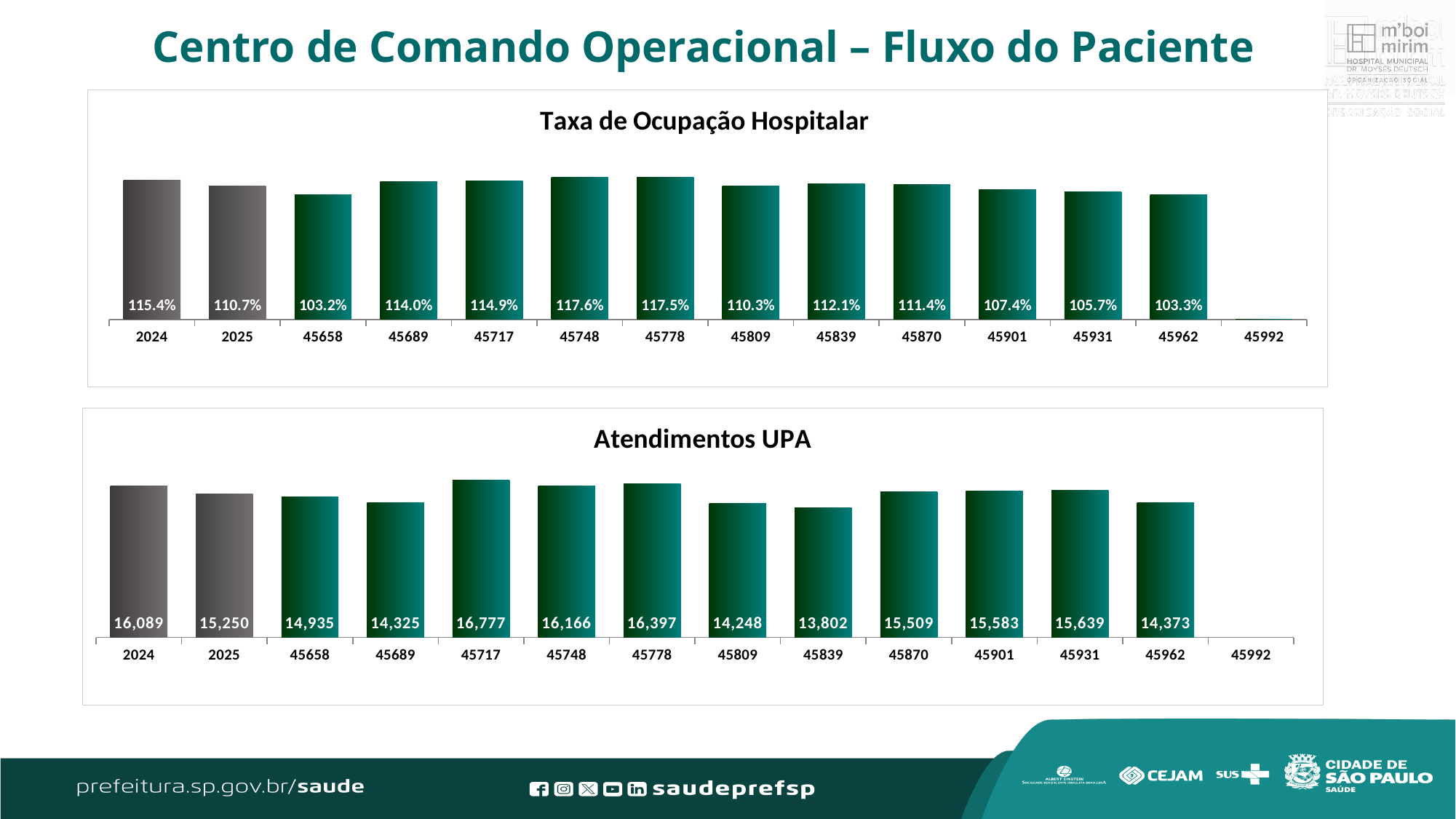
In the 'Taxa de Ocupação Hospitalar' chart, what is the difference between the 2024 and 2025 values? 4.7 percentage points In the 'Taxa de Ocupação Hospitalar' chart, what is the value for 45809? 110.3% In the 'Atendimentos UPA' chart, what is the value for 2025? 15,250 In the 'Atendimentos UPA' chart, what is the value for 45870? 15,509 In the 'Taxa de Ocupação Hospitalar' chart, which is larger, the value for 45901 or the value for 45931? 45901 In the 'Atendimentos UPA' chart, which category has the lowest value? 45839 What kind of chart is the 'Taxa de Ocupação Hospitalar' chart? Bar chart In the 'Atendimentos UPA' chart, which category has the highest value? 45717 How many categories are shown on the x axis of the 'Atendimentos UPA' chart? 14 In the 'Atendimentos UPA' chart, what is the difference between the 2024 and 2025 values? 839 In the 'Taxa de Ocupação Hospitalar' chart, what is the value for 2024? 115.4% In the 'Taxa de Ocupação Hospitalar' chart, which category has the highest value? 45748